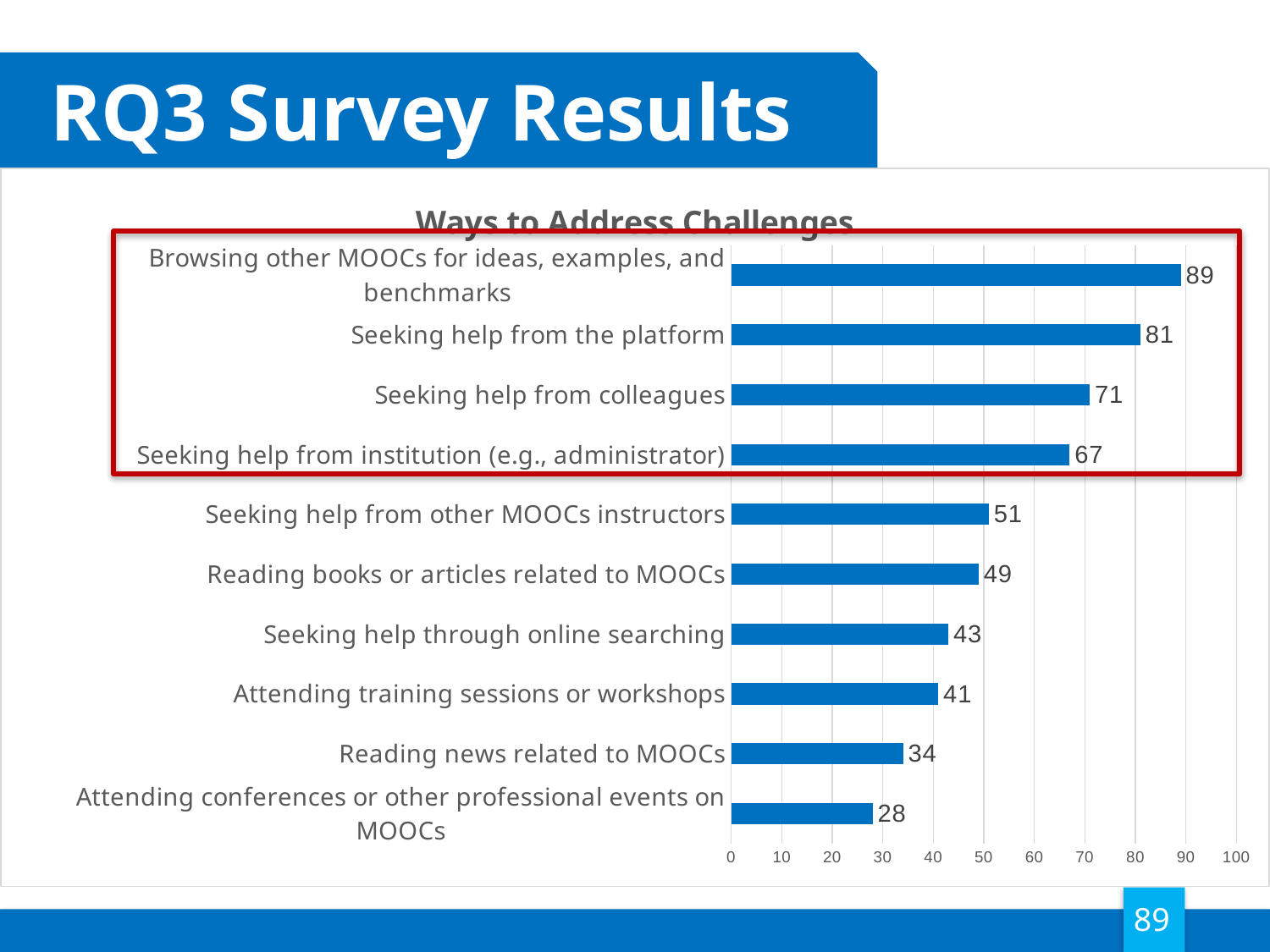
What is the value for Seeking help from the platform? 81 What is the difference between the values for Seeking help from colleagues and Seeking help from institution (e.g., administrator)? 4 Which category has the highest value? Browsing other MOOCs for ideas, examples, and benchmarks Which category has the lowest value? Attending conferences or other professional events on MOOCs What kind of chart is shown on the slide? bar chart What is the difference between the values for Browsing other MOOCs for ideas, examples, and benchmarks and Reading news related to MOOCs? 55 What is the value for Attending training sessions or workshops? 41 Is the value for Seeking help from the platform greater or less than 70? greater What is the title of the chart? Ways to Address Challenges What is the value for Reading books or articles related to MOOCs? 49 How many categories are shown in the chart? 10 Which is larger, the value for Seeking help through online searching or the value for Seeking help from other MOOCs instructors? Seeking help from other MOOCs instructors